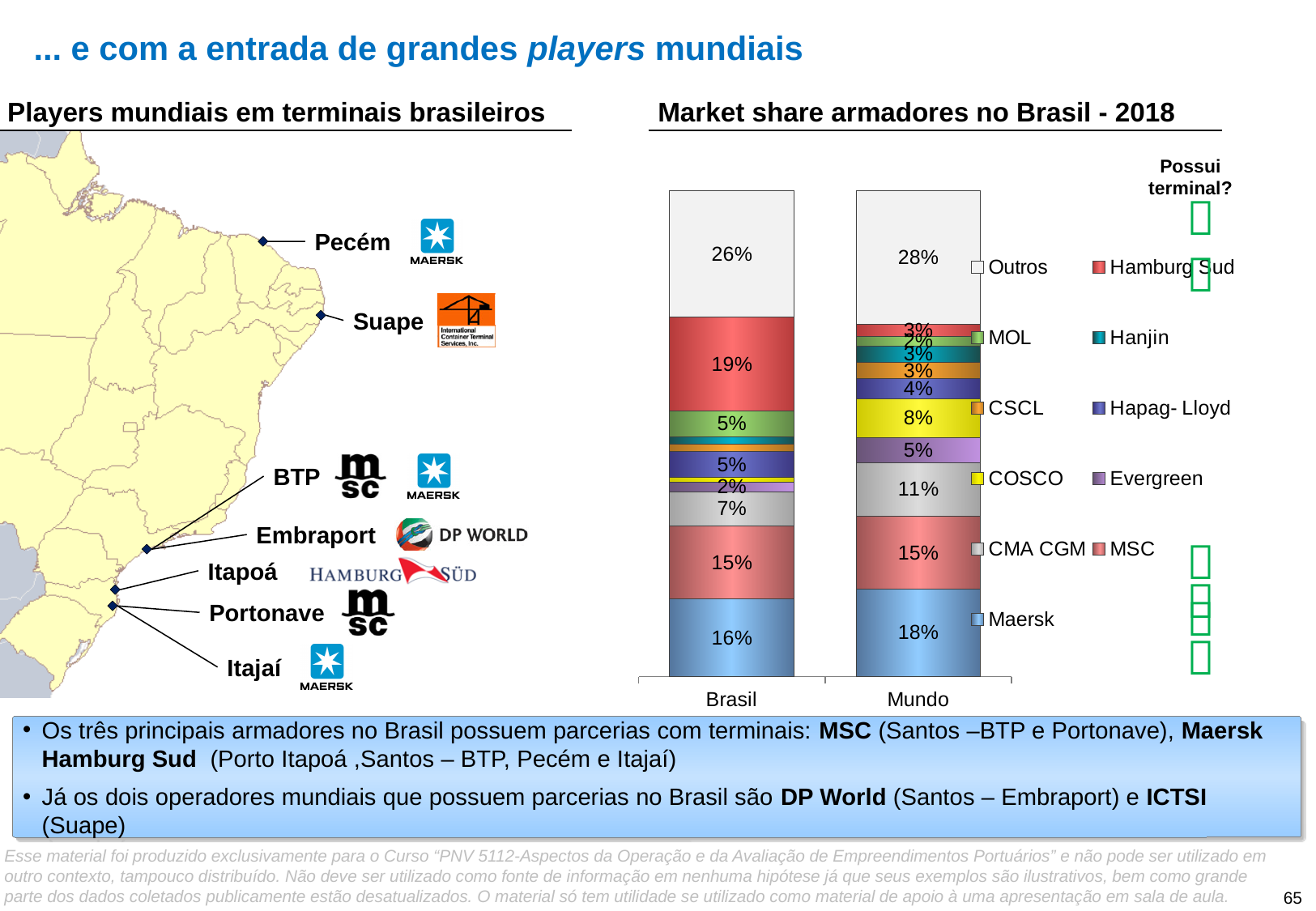
Is Maersk's share larger in the Brasil bar or the Mundo bar? Mundo Which named carrier (excluding 'Outros') has the largest share in the Brasil bar? Hamburg Sud What is the difference between Maersk's share in the Mundo bar and in the Brasil bar? 2 percentage points What is CMA CGM's share in the Mundo bar? 11% How many bars (categories) does the market share chart show? 2 What share does 'Outros' have in the Mundo bar? 28% What is the difference between CMA CGM's share in the Mundo bar and in the Brasil bar? 4 percentage points What is Hamburg Sud's market share in the Brasil bar? 19% What type of chart is used for 'Market share armadores no Brasil - 2018'? Stacked bar chart What is Maersk's market share in the Brasil bar? 16% What is COSCO's share in the Mundo bar? 8% How many series does the legend of the market share chart list? 11